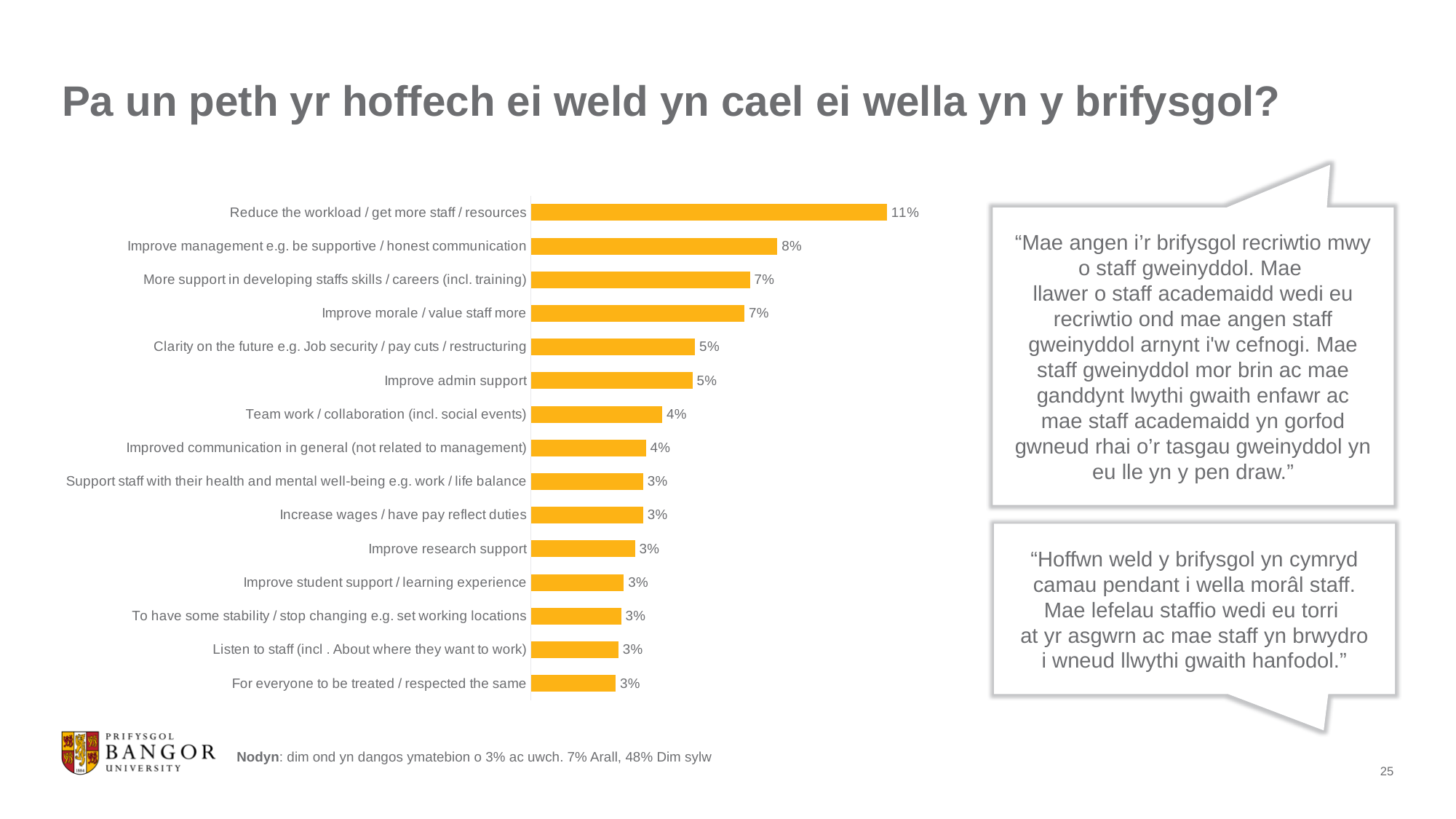
What kind of chart is shown on the slide? Bar chart What value is shown for "Team work / collaboration (incl. social events)"? 4% Do the bar values increase or decrease going from the top of the chart to the bottom? Decrease What is the difference between the values for "Reduce the workload / get more staff / resources" and "Improve management e.g. be supportive / honest communication"? 3% What value is shown for "Improve admin support"? 5% What is the difference between the values for "Improve management e.g. be supportive / honest communication" and "Clarity on the future e.g. Job security / pay cuts / restructuring"? 3% What value is shown for "Improve management e.g. be supportive / honest communication"? 8% Which has a larger value: "Improve morale / value staff more" or "Improve admin support"? Improve morale / value staff more Which category has the highest value in the chart? Reduce the workload / get more staff / resources What is the lowest value shown on any bar in the chart? 3% What percentage of respondents chose "Reduce the workload / get more staff / resources"? 11% How many categories are shown in the chart? 15